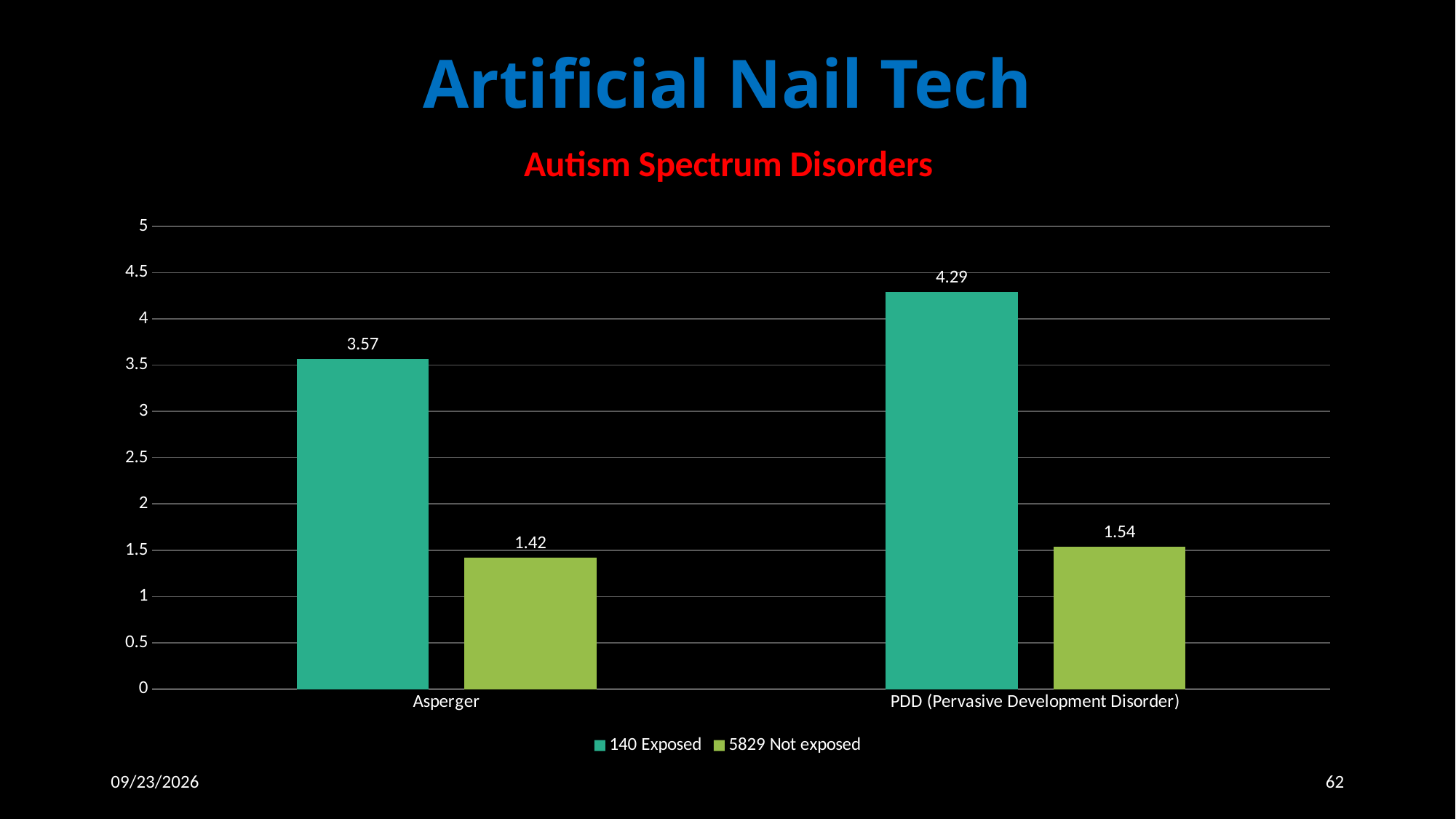
How many series does the legend list? 2 What is the value for the 140 Exposed series in the Asperger category? 3.57 What kind of chart is shown on the slide? bar chart Is the value for 140 Exposed in the PDD (Pervasive Development Disorder) category greater or less than 4? greater Which category has the lowest value for the 5829 Not exposed series? Asperger How many categories are shown on the x axis? 2 Which is larger in the Asperger category: the 140 Exposed value or the 5829 Not exposed value? 140 Exposed What is the value for the 5829 Not exposed series in the PDD (Pervasive Development Disorder) category? 1.54 What is the difference between the 140 Exposed and 5829 Not exposed values in the PDD (Pervasive Development Disorder) category? 2.75 What is the title of the chart? Autism Spectrum Disorders Which category has the highest value for the 140 Exposed series? PDD (Pervasive Development Disorder) What is the value for the 5829 Not exposed series in the Asperger category? 1.42